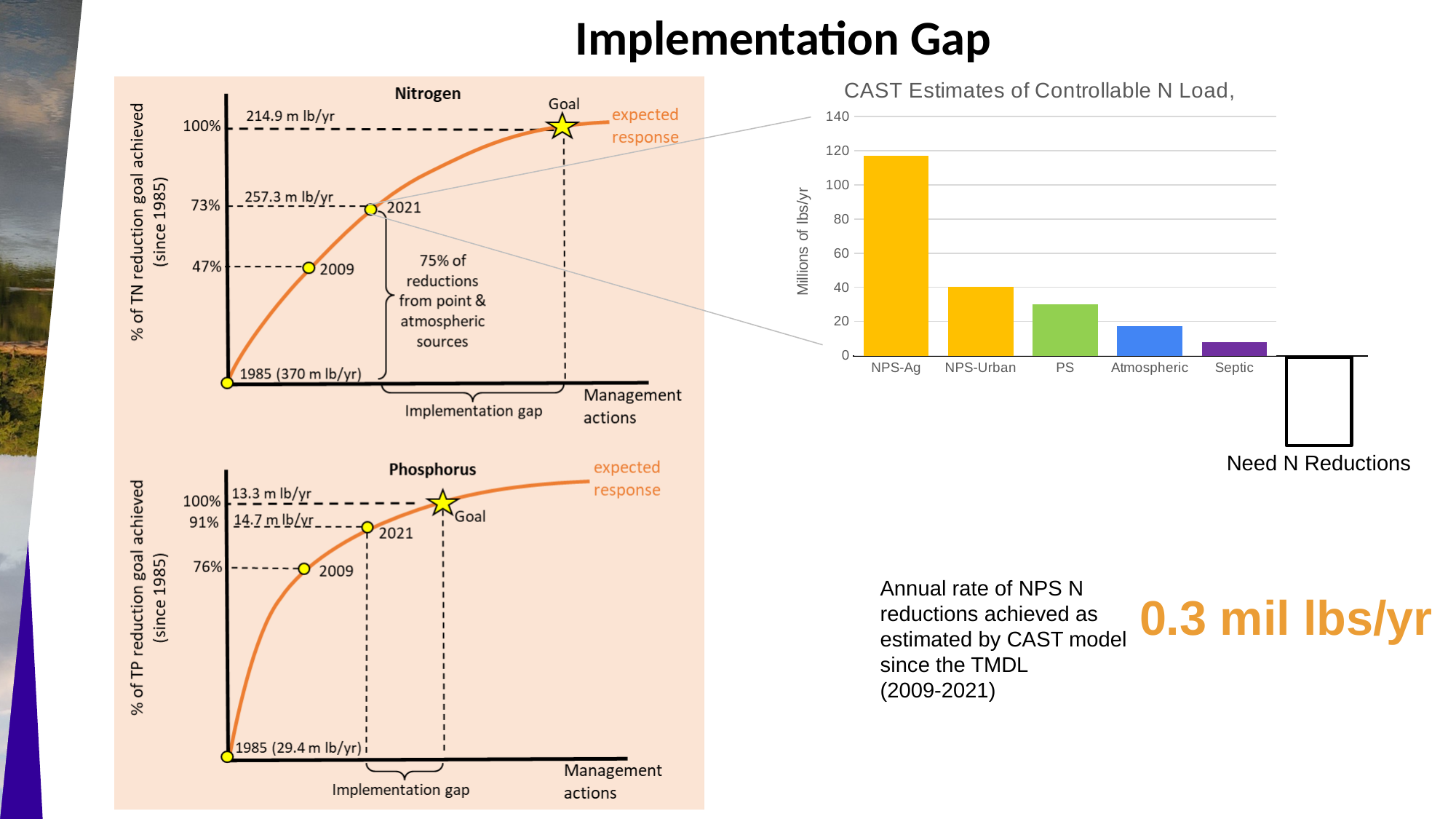
In the 'CAST Estimates of Controllable N Load' chart, is the value for Atmospheric greater or less than 20? less In the 'CAST Estimates of Controllable N Load' chart, is the value for PS greater or less than 40? less What kind of chart is the 'CAST Estimates of Controllable N Load' chart? bar chart In the 'CAST Estimates of Controllable N Load' chart, do the bar values rise or fall from left to right along the x axis? fall How many categories are shown on the x axis of the 'CAST Estimates of Controllable N Load' chart? 5 In the 'CAST Estimates of Controllable N Load' chart, which category has the highest value? NPS-Ag In the Nitrogen diagram on the left, what percent of the TN reduction goal was achieved by 2021? 73% In the 'CAST Estimates of Controllable N Load' chart, is the value for NPS-Ag greater or less than 100? greater What is the y-axis label of the 'CAST Estimates of Controllable N Load' chart? Millions of lbs/yr In the 'CAST Estimates of Controllable N Load' chart, which is larger, NPS-Urban or PS? NPS-Urban In the Phosphorus diagram on the left, what percent of the TP reduction goal was achieved by 2009? 76% In the 'CAST Estimates of Controllable N Load' chart, which category has the lowest value? Septic